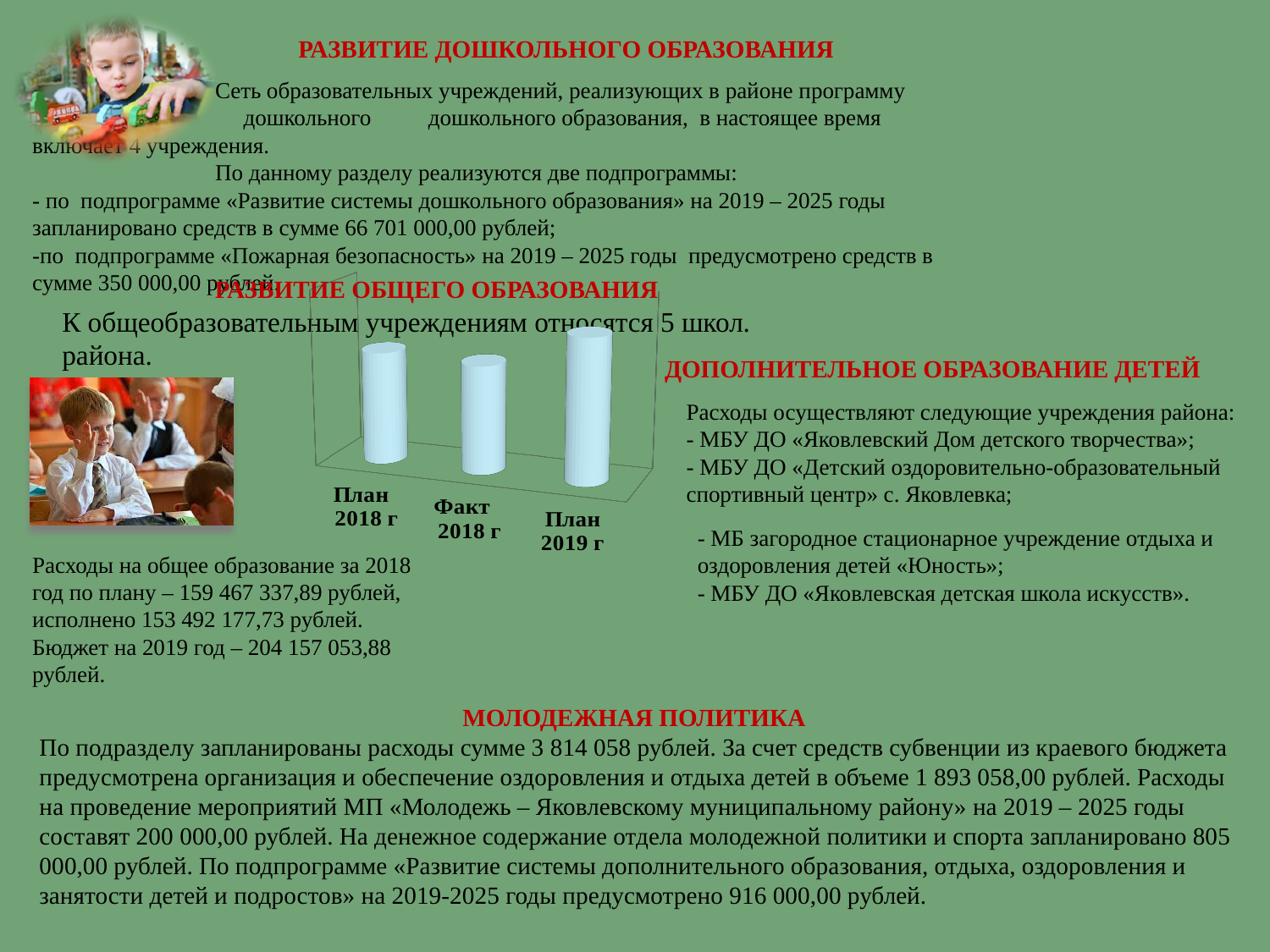
Which bar is taller, План 2018 г or План 2019 г? План 2019 г What is the label of the first (leftmost) bar in the chart? План 2018 г What kind of chart is shown on the slide? bar chart Which category has the tallest bar in the chart? План 2019 г Which bar is taller, Факт 2018 г or План 2019 г? План 2019 г How many bars does the chart show? 3 What is the label of the last (rightmost) bar in the chart? План 2019 г